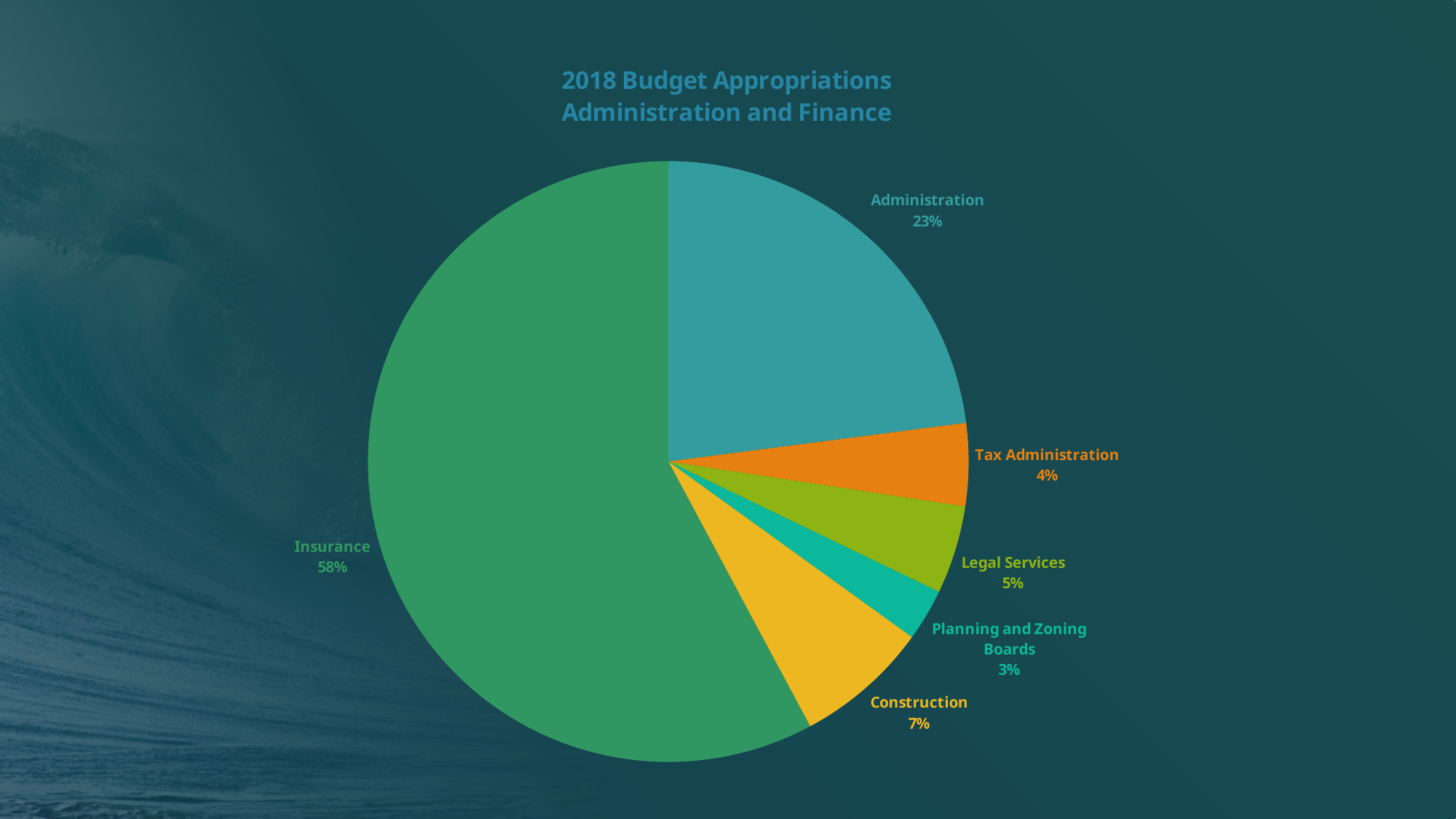
How many categories are shown in the pie chart? 6 What is the value shown for Administration? 23% What is the difference between the Insurance share and the Administration share? 35% What share of the pie does Insurance represent? 58% What kind of chart is shown on the slide? Pie chart What is the title of the chart? 2018 Budget Appropriations Administration and Finance Which category has the largest slice of the pie? Insurance What is the combined share of Construction and Legal Services? 12% Which category has the smallest slice of the pie? Planning and Zoning Boards What is the value shown for Planning and Zoning Boards? 3% What is the value shown for Construction? 7% Which is larger, Legal Services or Tax Administration? Legal Services